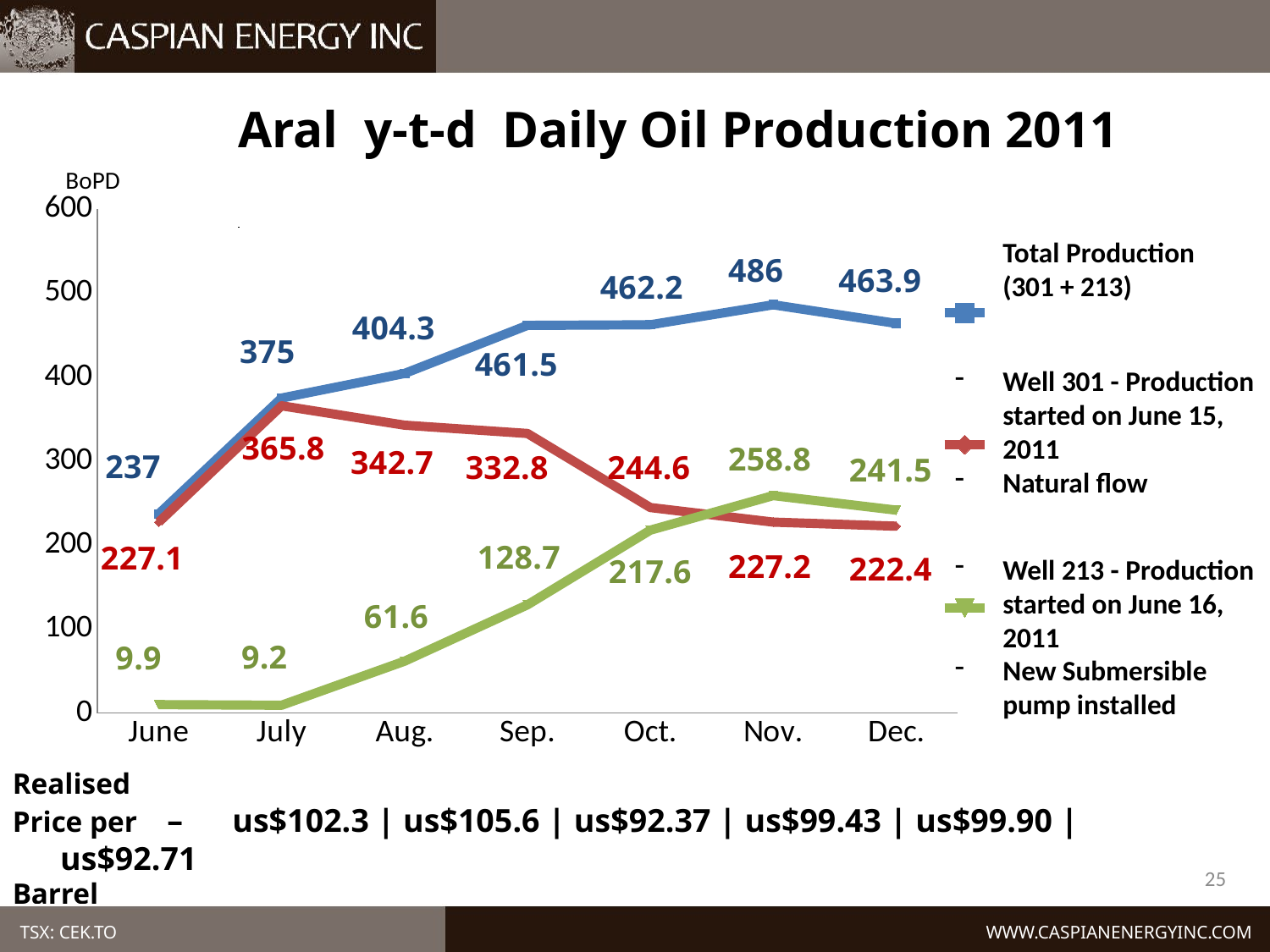
Did Well 301 production rise or fall from July to December? fall How many months are plotted along the x axis? 7 What unit is shown on the y axis? BoPD In which month was Well 213 production lowest? July What was the Total Production in November? 486 In which month was Total Production highest? Nov. What is the difference between Well 301 production in July and in December? 143.4 In December, which was larger: Well 213 production or Well 301 production? Well 213 How many series does the legend list? 3 What was the Well 301 production in July? 365.8 What type of chart is shown on the slide? line chart What was the Well 213 production in September? 128.7